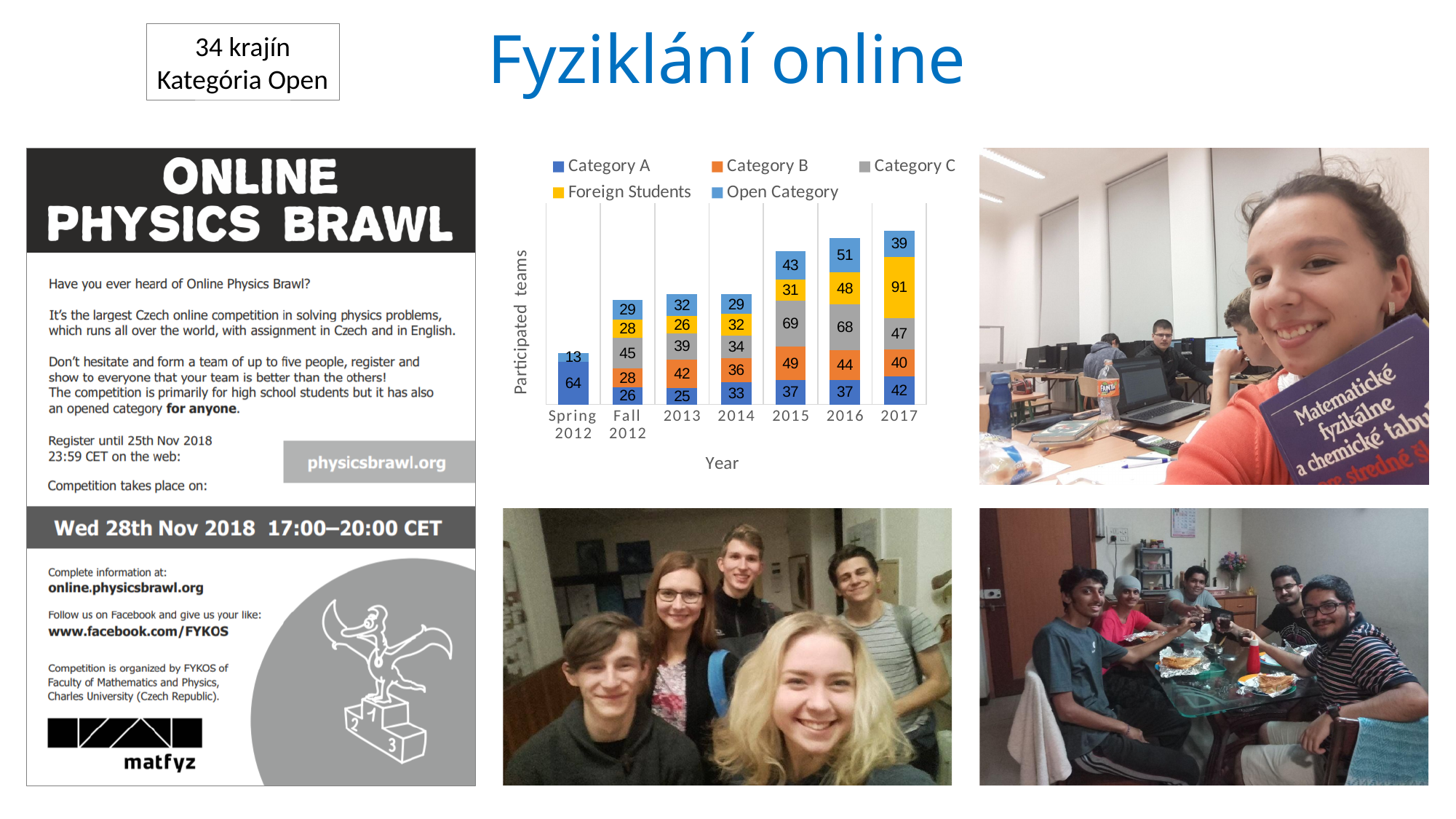
How many years (categories) are shown on the x axis of the chart? 7 What is the value for Category A in Spring 2012? 64 In which year is the Foreign Students value highest? 2017 What kind of chart is shown on the slide? stacked bar chart Which is larger, the Category C value in 2016 or the Category C value in 2017? 2016 What is the value for Open Category in 2016? 51 What is the value for Category C in 2015? 69 What is the difference between the Category B values in 2015 and 2014? 13 In which year is the Category A value lowest? 2013 What is the total number of participated teams in 2017 (sum of all segments)? 259 How many series does the chart legend list? 5 What is the value for Foreign Students in 2017? 91